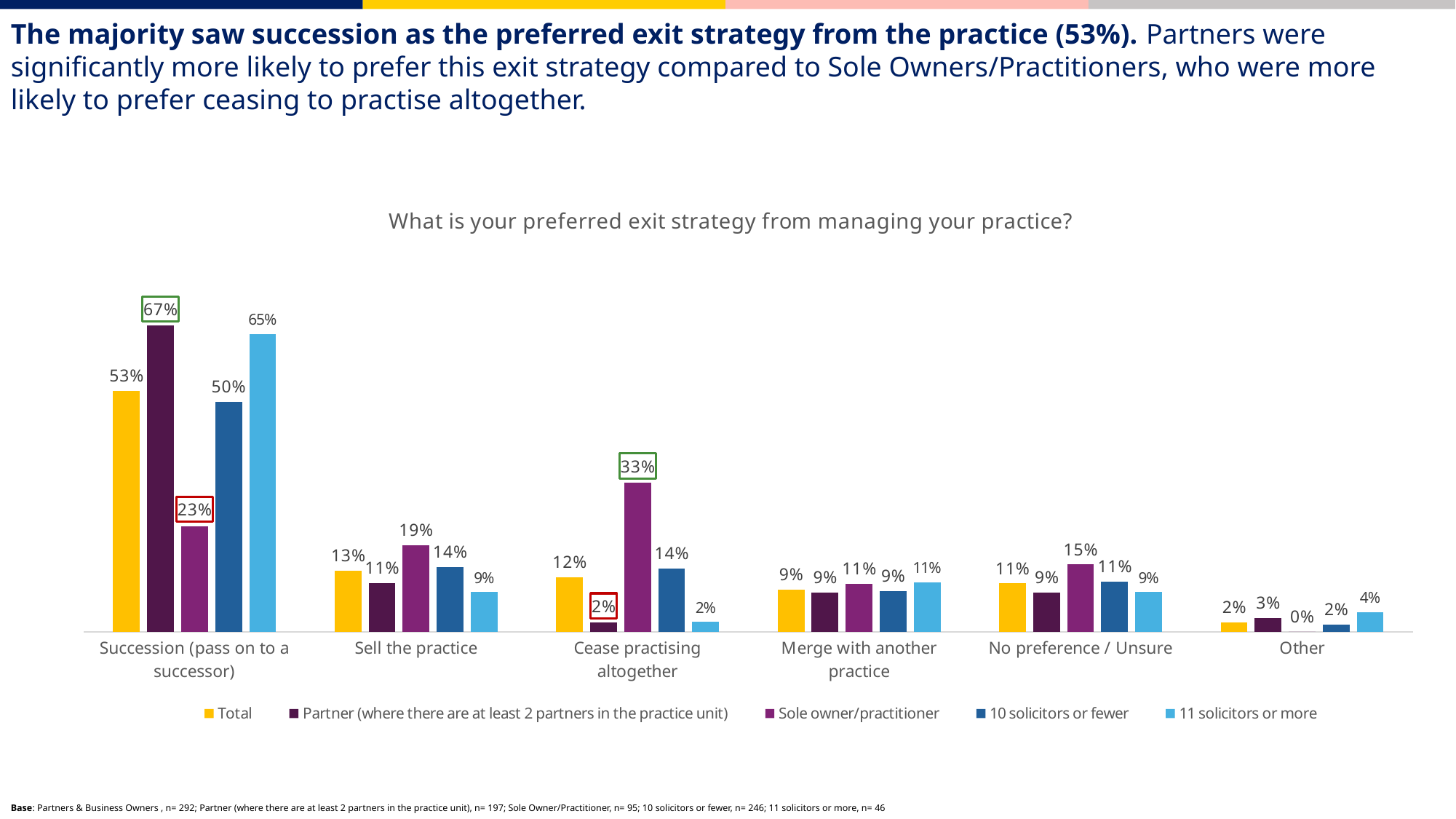
Which category has the highest Total value? Succession (pass on to a successor) Which category has the lowest Sole owner/practitioner value? Other What kind of chart is shown on the slide? Bar chart What is the difference between the Partner and Sole owner/practitioner values for Succession (pass on to a successor)? 44 percentage points What is the Sole owner/practitioner value for Cease practising altogether? 33% How many series does the legend list? 5 What is the Total value for Succession (pass on to a successor)? 53% What is the title of the chart? What is your preferred exit strategy from managing your practice? How many exit strategy categories are shown on the x axis? 6 What is the 11 solicitors or more value for Other? 4% What is the Partner value for Succession (pass on to a successor)? 67% For Cease practising altogether, which is larger: the Partner value or the Sole owner/practitioner value? Sole owner/practitioner